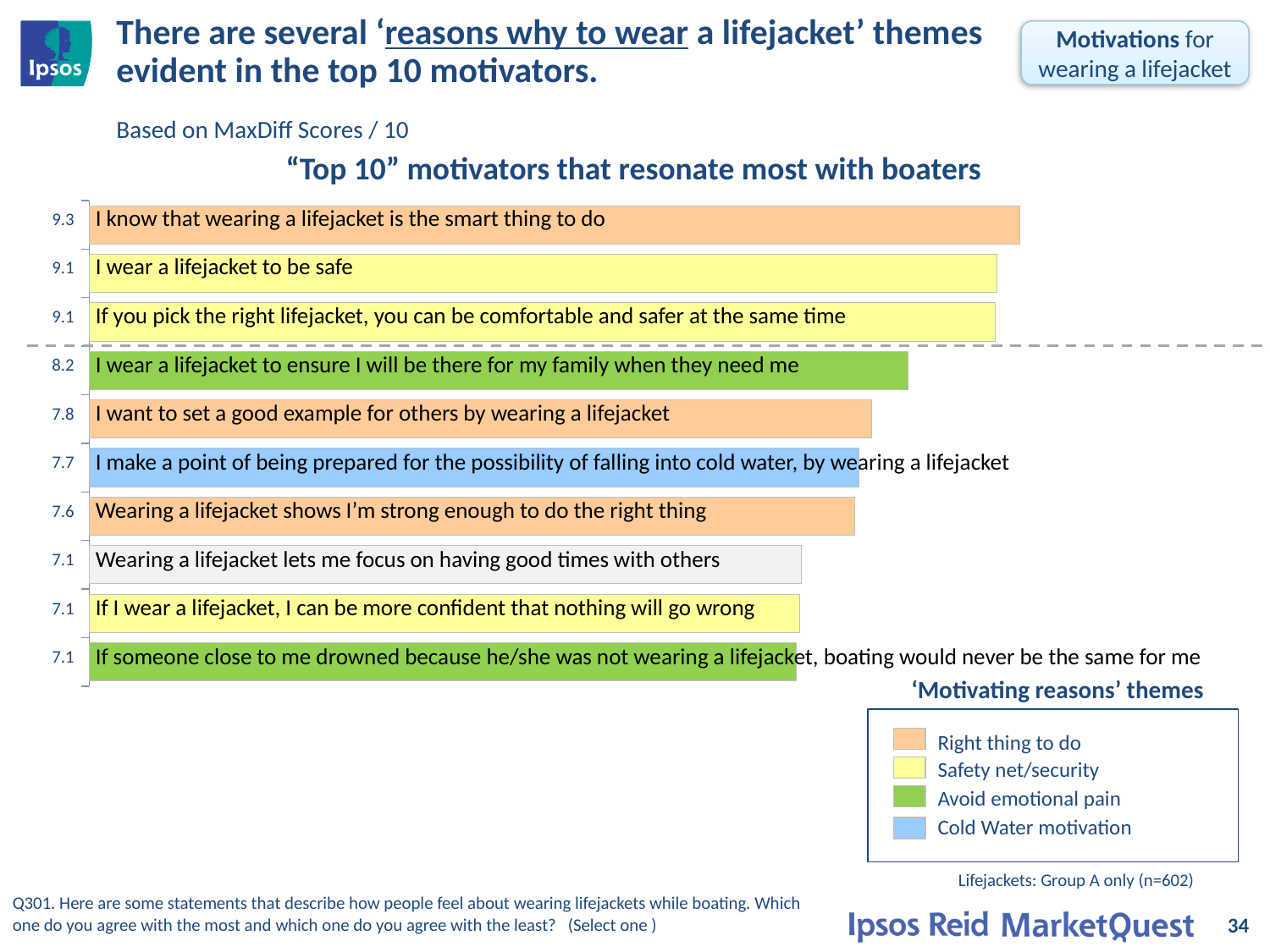
What is the MaxDiff score for "Wearing a lifejacket lets me focus on having good times with others"? 7.1 How many motivators are shown in the chart? 10 What is the difference between the MaxDiff scores for "I wear a lifejacket to ensure I will be there for my family when they need me" and "I want to set a good example for others by wearing a lifejacket"? 0.4 What is the MaxDiff score for "I know that wearing a lifejacket is the smart thing to do"? 9.3 What is the MaxDiff score for "I make a point of being prepared for the possibility of falling into cold water, by wearing a lifejacket"? 7.7 What is the difference between the MaxDiff scores for "I know that wearing a lifejacket is the smart thing to do" and "I wear a lifejacket to be safe"? 0.2 Which theme in the legend is represented by the green colour? Avoid emotional pain What type of chart is shown on the slide? Bar chart Which motivator has the highest MaxDiff score? I know that wearing a lifejacket is the smart thing to do What is the MaxDiff score for "I wear a lifejacket to ensure I will be there for my family when they need me"? 8.2 Which has a higher MaxDiff score: "I want to set a good example for others by wearing a lifejacket" or "Wearing a lifejacket shows I'm strong enough to do the right thing"? I want to set a good example for others by wearing a lifejacket How many themes does the 'Motivating reasons' themes legend list? 4